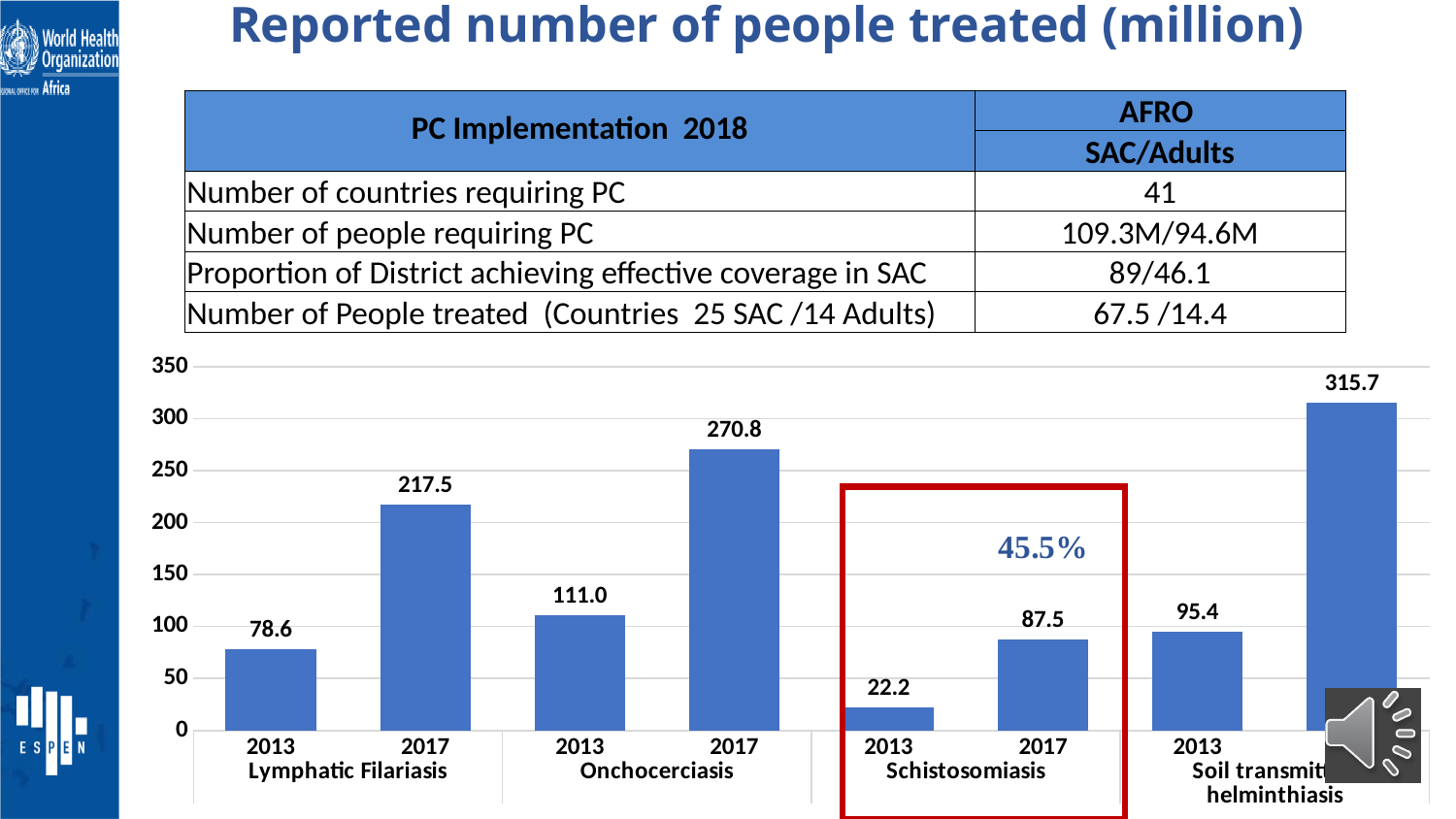
What percentage is written inside the red box highlighting Schistosomiasis? 45.5% Which is larger, the 2013 value for Onchocerciasis or the 2013 value for Soil transmitted helminthiasis? Onchocerciasis What is the difference between the 2017 and 2013 values for Schistosomiasis? 65.3 Which bar in the chart has the lowest value? Schistosomiasis 2013 What is the reported number of people treated for Onchocerciasis in 2017? 270.8 What kind of chart is shown on the slide? bar chart What is the difference between the 2017 and 2013 values for Lymphatic Filariasis? 138.9 What is the reported number of people treated for Soil transmitted helminthiasis in 2013? 95.4 Which disease has the tallest bar in the chart? Soil transmitted helminthiasis How many bars are plotted in the chart? 8 What is the reported number of people treated for Lymphatic Filariasis in 2013? 78.6 What is the reported number of people treated for Schistosomiasis in 2013? 22.2